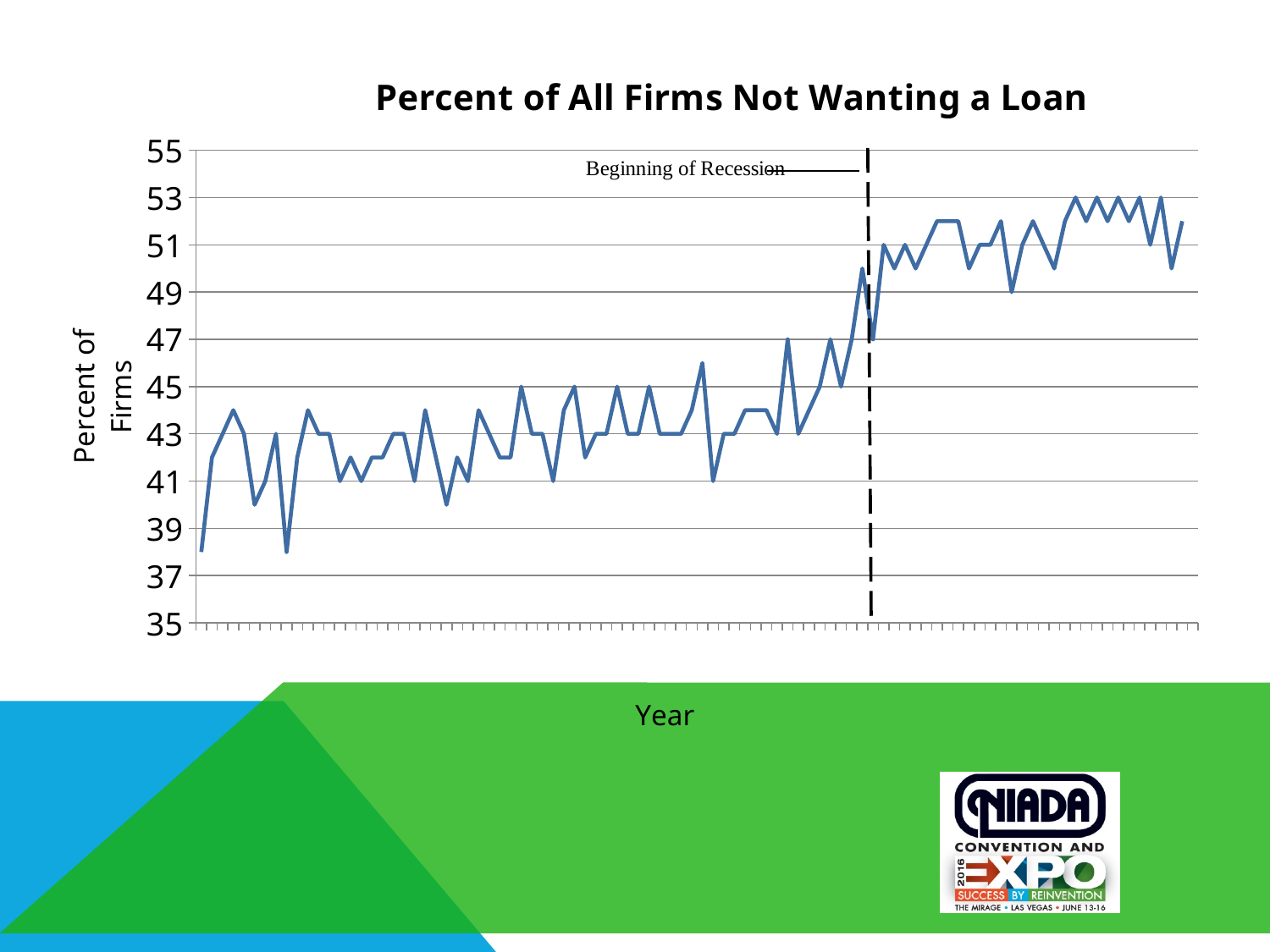
Are the values after the dashed recession line generally higher or lower than the values before it? higher What kind of chart is shown on the slide? line chart What event does the dashed vertical line on the chart mark? Beginning of Recession Is the value at the last plotted point greater or less than 51? greater What is the title of the chart? Percent of All Firms Not Wanting a Loan Is the value at the first plotted point greater or less than 41? less Is the highest value on the chart greater or less than 51? greater Overall, do the values rise or fall from left to right along the x axis? rise